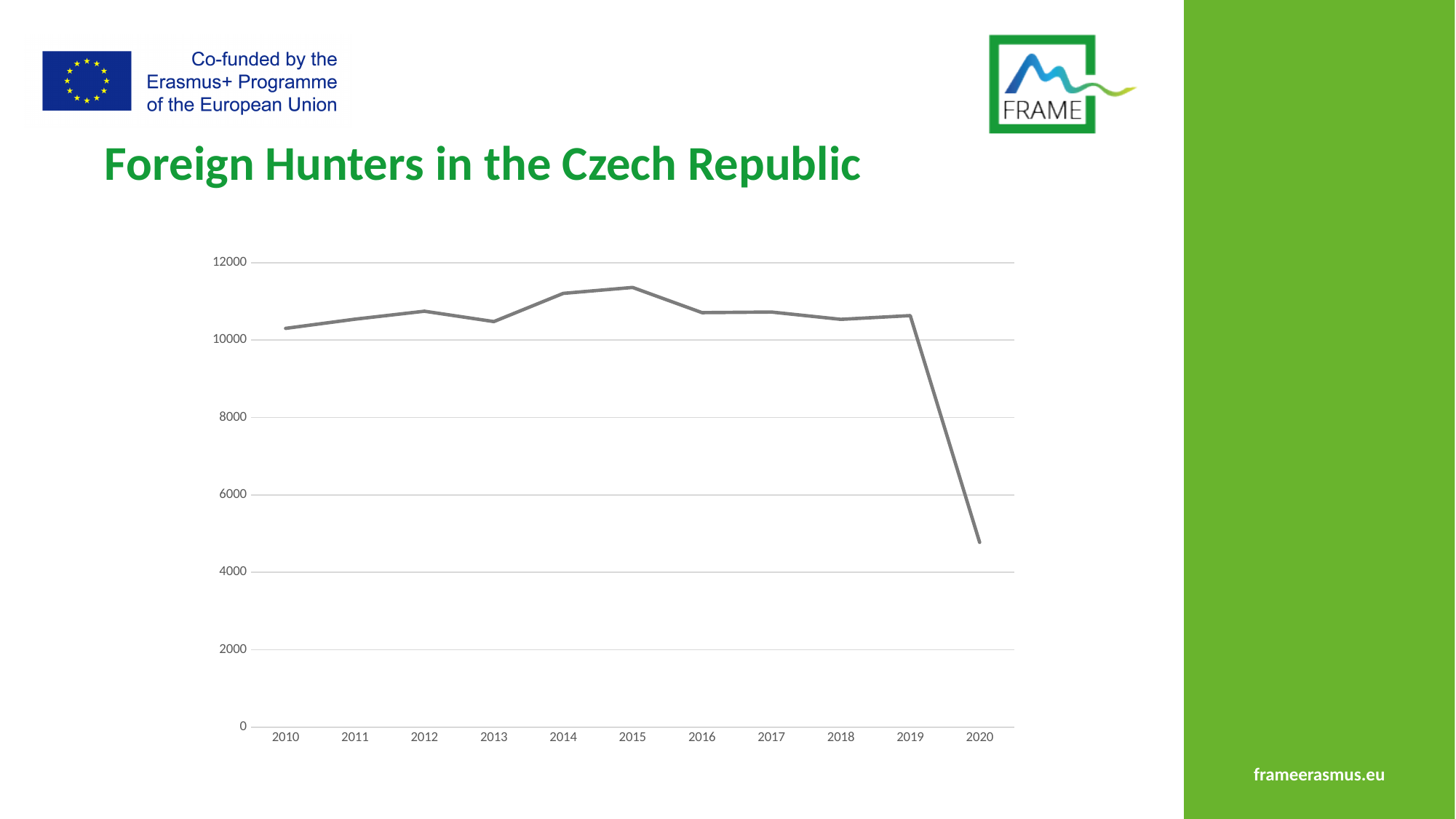
Is the value for 2020 greater or less than 4000? greater Which year has the highest number of foreign hunters? 2015 Which is larger, the value for 2019 or the value for 2020? 2019 Is the value for 2010 greater or less than 10000? greater Is the value for 2015 greater or less than 12000? less Which is larger, the value for 2014 or the value for 2010? 2014 Does the line rise or fall between 2019 and 2020? fall What is the title of the slide above the chart? Foreign Hunters in the Czech Republic How many years are plotted along the x axis? 11 Which year has the lowest number of foreign hunters? 2020 What kind of chart is shown on the slide? line chart